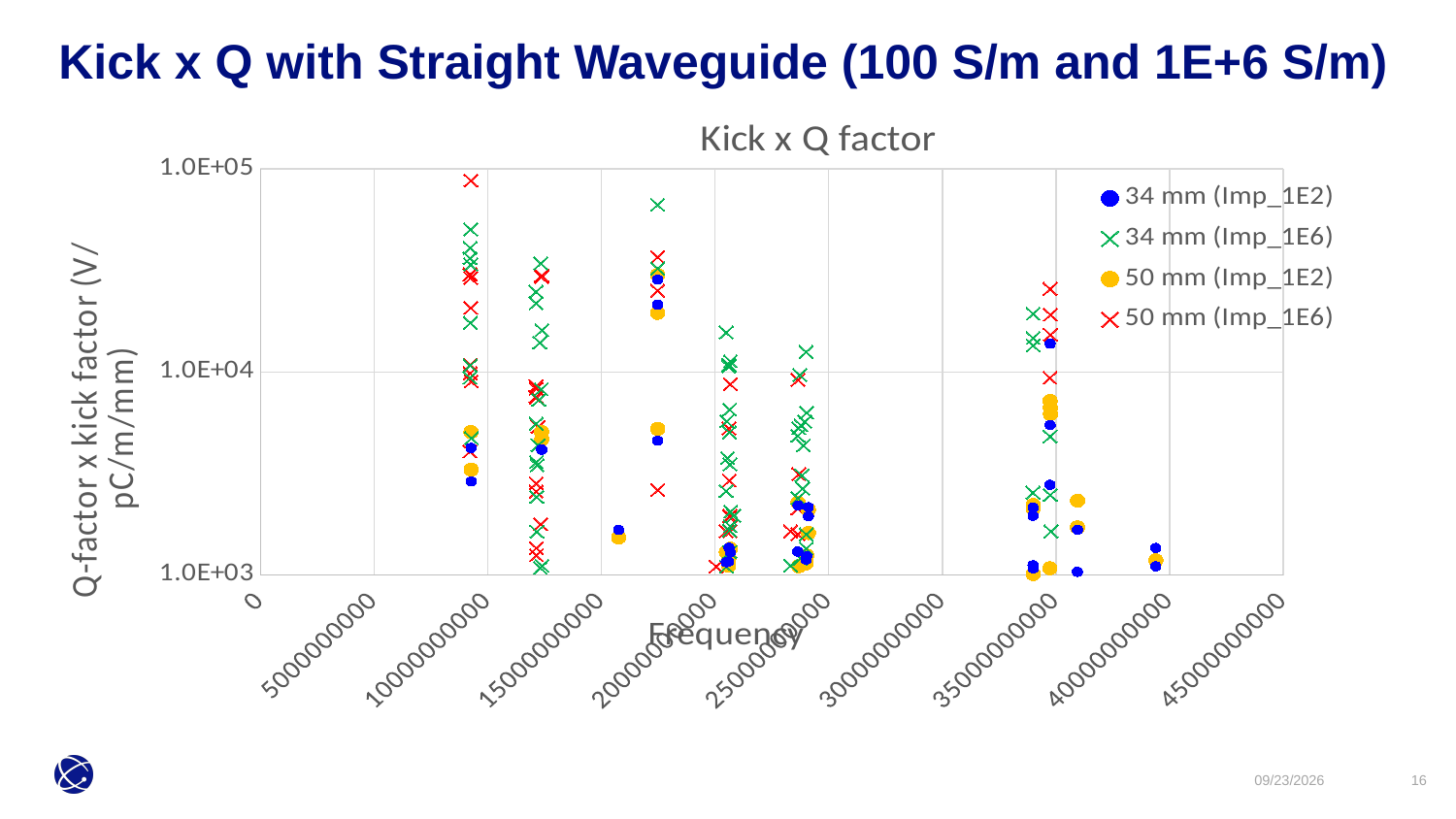
How many series does the legend list? 4 Which series is plotted with red x markers? 50 mm (Imp_1E6) Is the highest plotted value for the 50 mm (Imp_1E6) series greater or less than 1.0E+04? greater Which series has the single highest plotted point on the chart? 50 mm (Imp_1E6) What is the highest value shown on the x axis? 45000000000 What is the title of the chart? Kick x Q factor What kind of chart is shown on the slide? Scatter chart Is the highest plotted value for the 34 mm (Imp_1E2) series greater or less than 1.0E+04? greater What is the lowest value shown on the y axis? 1.0E+03 Is the highest plotted value for the 34 mm (Imp_1E6) series greater or less than 1.0E+05? less What is the label of the x axis? Frequency